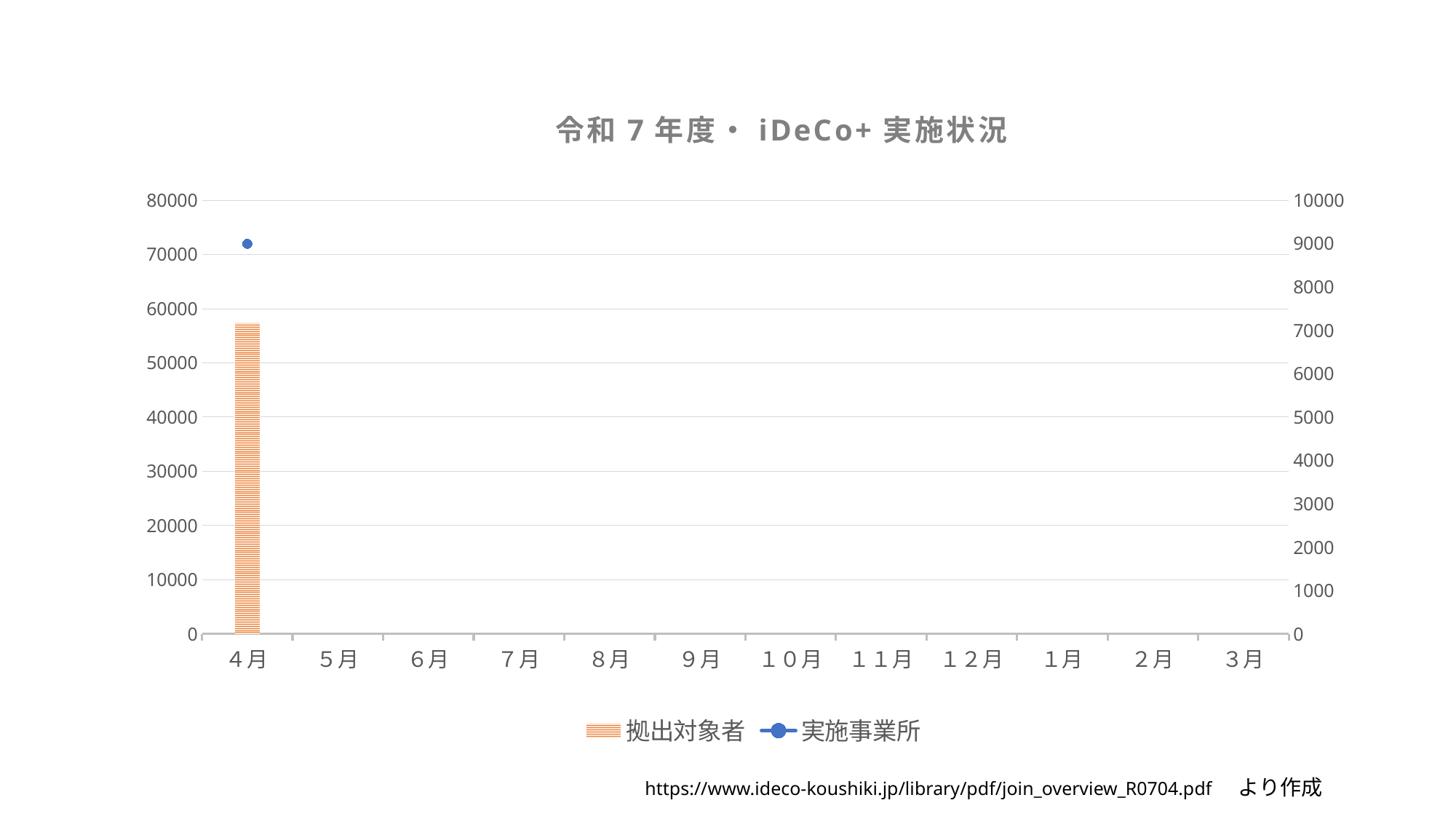
How many month categories are shown on the x axis? 12 What is the maximum value shown on the right-hand vertical axis? 10000 Is the value for 拠出対象者 in 4月 greater or less than 60000? less Which month has a bar plotted for 拠出対象者? 4月 What is the title of the chart? 令和7年度・iDeCo+実施状況 What kind of chart is shown on the slide? combination bar and line chart Is the value for 拠出対象者 in 4月 greater or less than 50000? greater How many series does the legend list? 2 Is the value for 実施事業所 in 4月 greater or less than 8000 on the right axis? greater What are the two series named in the legend? 拠出対象者 and 実施事業所 For how many months is data plotted on the chart? 1